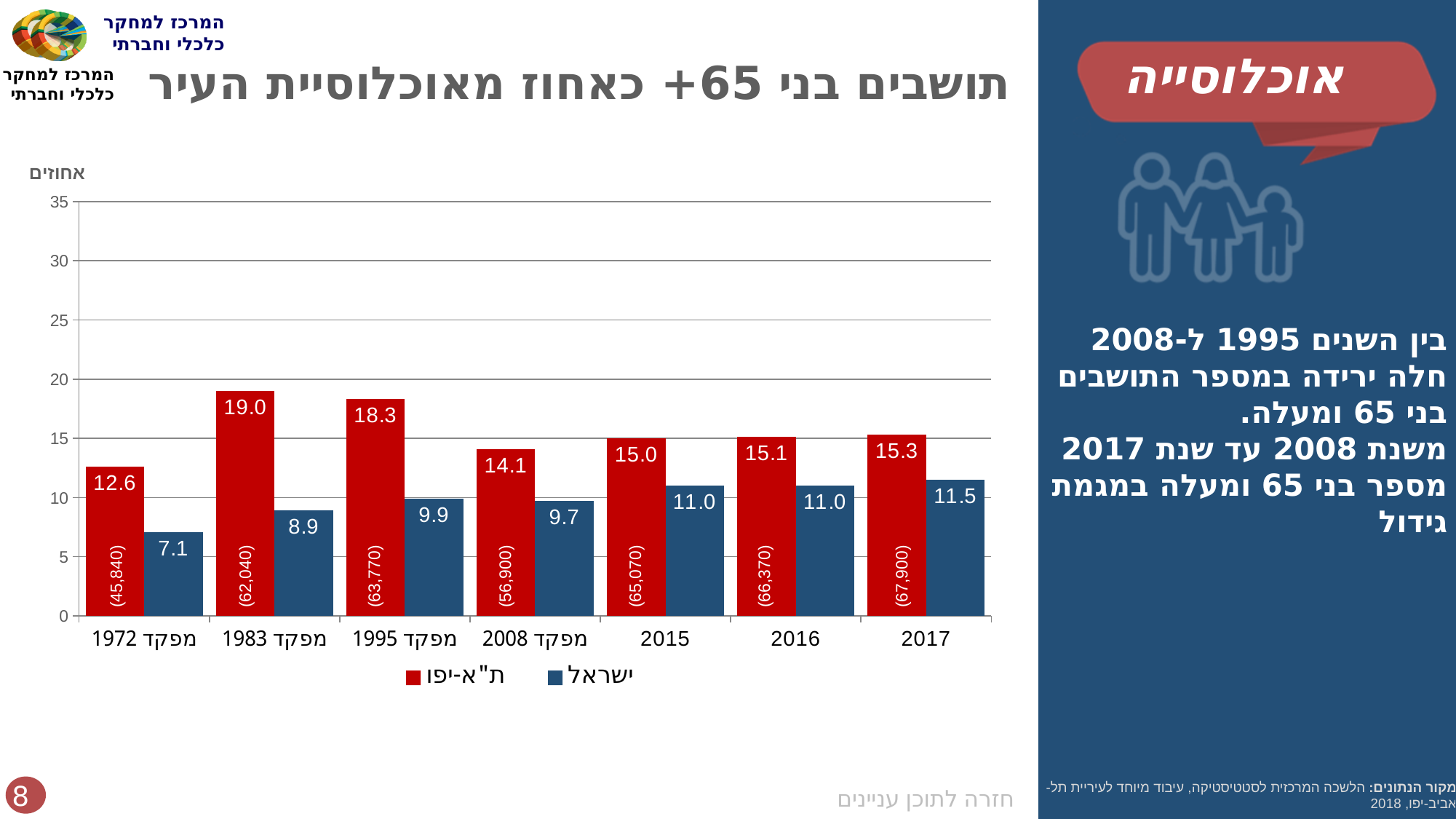
Which is larger: the ת"א-יפו value in 2015 or in מפקד 2008? 2015 What is the difference between the ת"א-יפו and ישראל values in מפקד 1995? 8.4 In which category is the ישראל value lowest? מפקד 1972 What absolute number is printed inside the ת"א-יפו bar for מפקד 2008? (56,900) What is the value for ישראל in 2017? 11.5 What is the value for ת"א-יפו in מפקד 1983? 19.0 Do the ישראל values rise or fall from מפקד 2008 to 2017? rise Is the ת"א-יפו value for מפקד 1972 greater or less than 10? greater How many series does the legend list? 2 What kind of chart is shown on the slide? bar chart How many categories are shown on the x axis? 7 In which category is the ת"א-יפו value highest? מפקד 1983